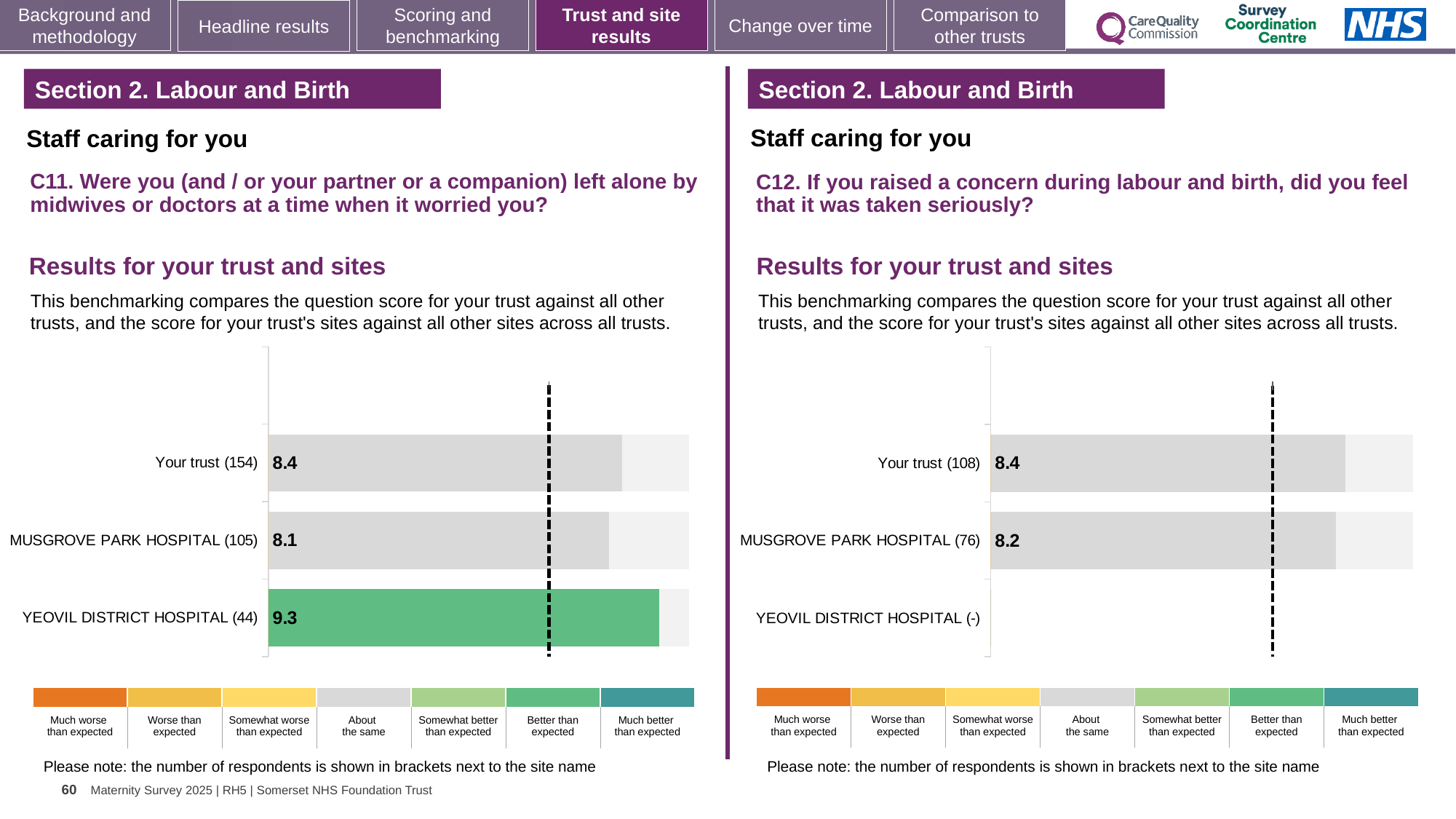
How many respondents are shown in brackets for YEOVIL DISTRICT HOSPITAL in the left chart (C11)? 44 In the left chart (C11), what is the difference between the scores for YEOVIL DISTRICT HOSPITAL and MUSGROVE PARK HOSPITAL? 1.2 In the left chart (C11), what is the score for MUSGROVE PARK HOSPITAL? 8.1 In the left chart (C11), which site or trust has the lowest score? MUSGROVE PARK HOSPITAL In the left chart (C11), which bar is coloured green rather than grey? YEOVIL DISTRICT HOSPITAL In the left chart (C11), what is the score for YEOVIL DISTRICT HOSPITAL? 9.3 In the left chart (C11), which site or trust has the highest score? YEOVIL DISTRICT HOSPITAL What type of chart is used on the left (C11)? Bar chart In the right chart (C12), what is the difference between the scores for Your trust and MUSGROVE PARK HOSPITAL? 0.2 In the right chart (C12), what is the score for Your trust? 8.4 In the right chart (C12), what is the score for MUSGROVE PARK HOSPITAL? 8.2 In the right chart (C12), which has the larger score, Your trust or MUSGROVE PARK HOSPITAL? Your trust